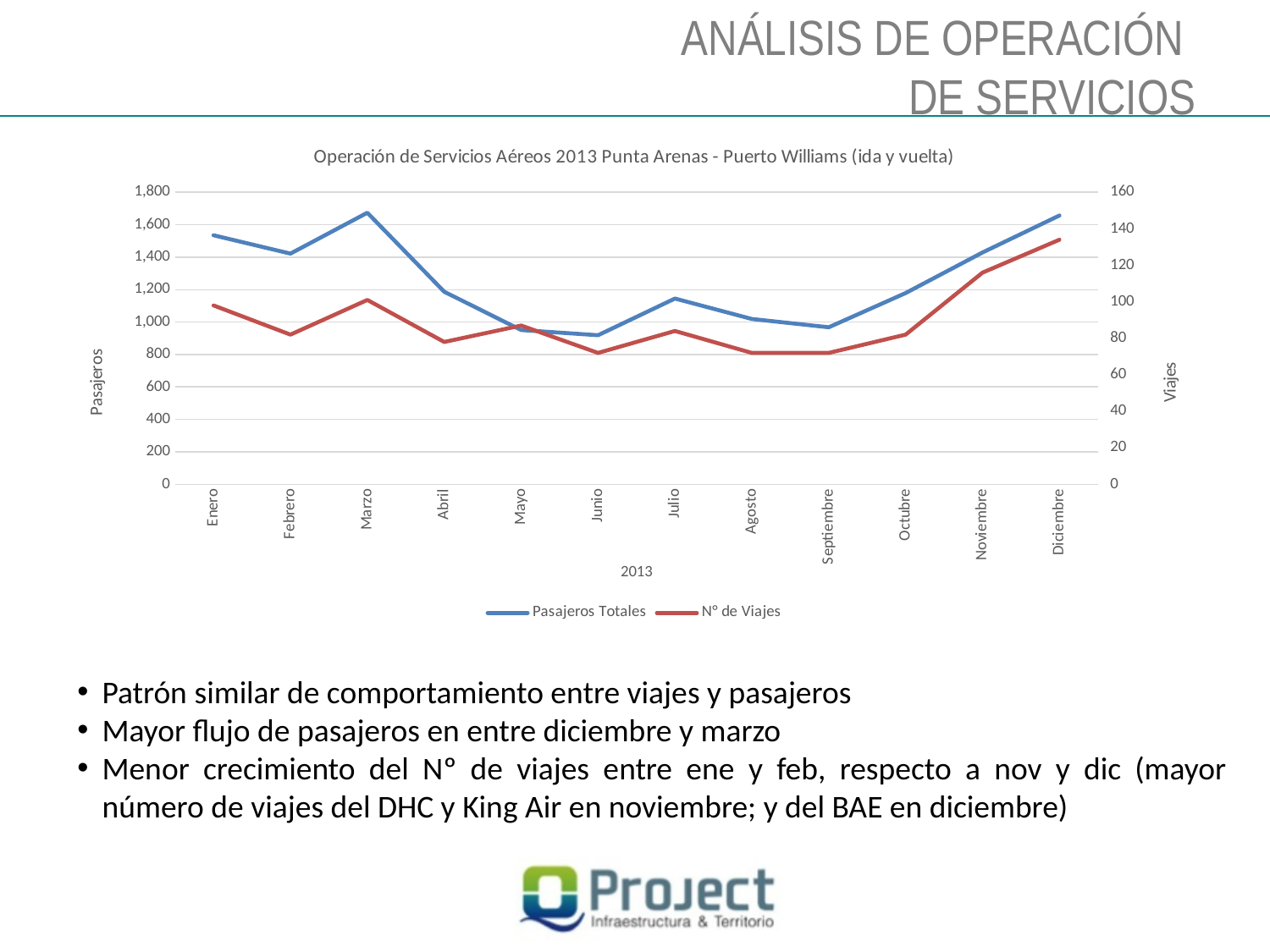
What kind of chart is shown on the slide? line chart What is the title of the chart? Operación de Servicios Aéreos 2013 Punta Arenas - Puerto Williams (ida y vuelta) Which month has the highest value for N° de Viajes? Diciembre Is the value of Pasajeros Totales for Marzo greater or less than 1,600? greater Do the Pasajeros Totales values rise or fall from Septiembre to Diciembre? rise Which is larger, Pasajeros Totales in Marzo or in Mayo? Marzo Is the value of Pasajeros Totales for Junio greater or less than 1,000? less Is the value of N° de Viajes for Diciembre greater or less than 120? greater Which is larger, N° de Viajes in Diciembre or in Enero? Diciembre How many months are plotted along the x axis? 12 How many series does the legend list? 2